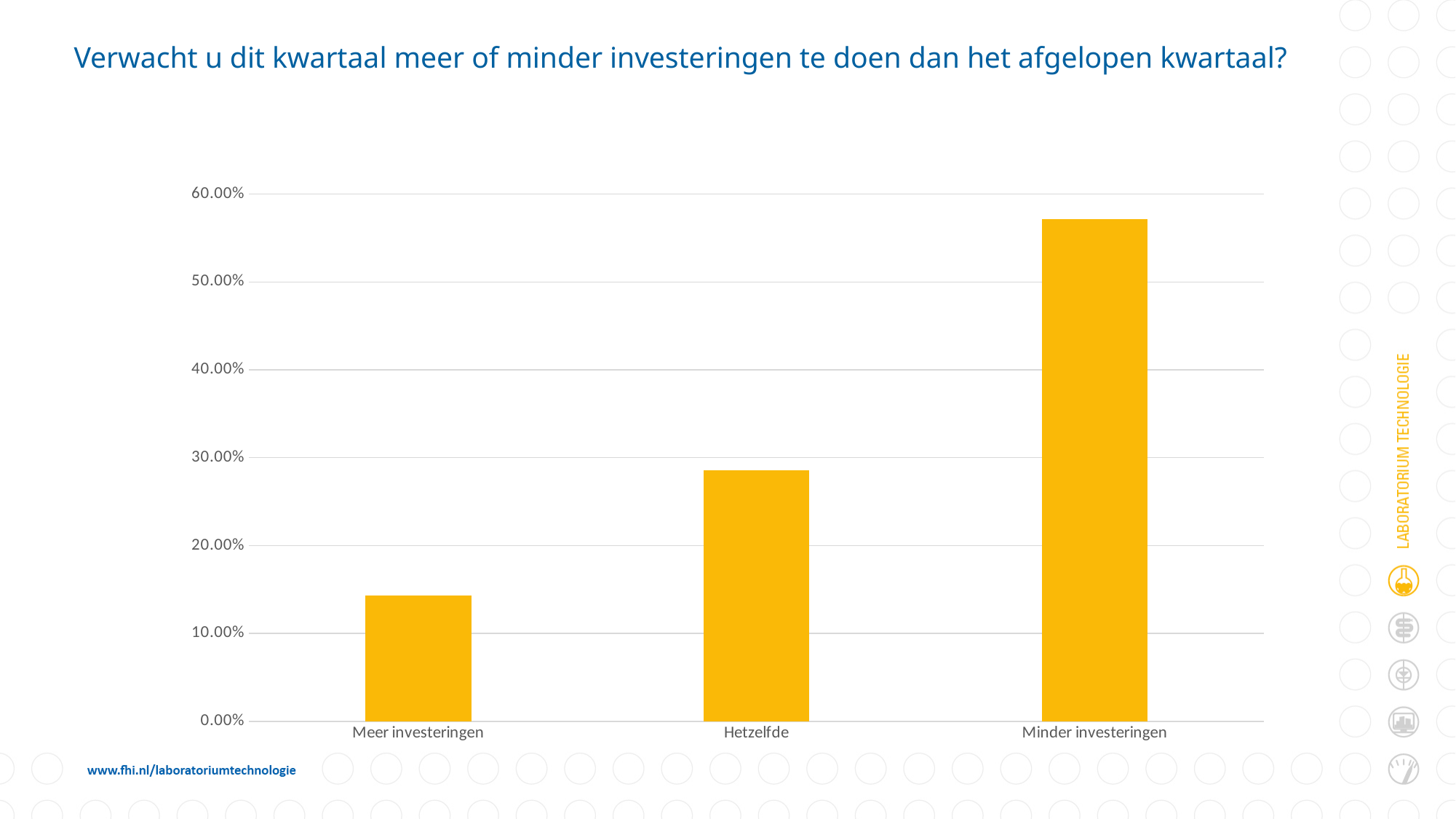
Is the value for Meer investeringen greater or less than 10.00%? greater Is the value for Minder investeringen greater or less than 60.00%? less Is the value for Minder investeringen greater or less than 50.00%? greater Do the bar values rise or fall from left to right along the x axis? rise Which category has the highest value? Minder investeringen Which category has the lowest value? Meer investeringen What is the title of the slide above the chart? Verwacht u dit kwartaal meer of minder investeringen te doen dan het afgelopen kwartaal? How many categories are shown on the x axis of the chart? 3 Which is larger, the value for Hetzelfde or the value for Meer investeringen? Hetzelfde What kind of chart is shown on the slide? bar chart Which is larger, the value for Minder investeringen or the value for Hetzelfde? Minder investeringen